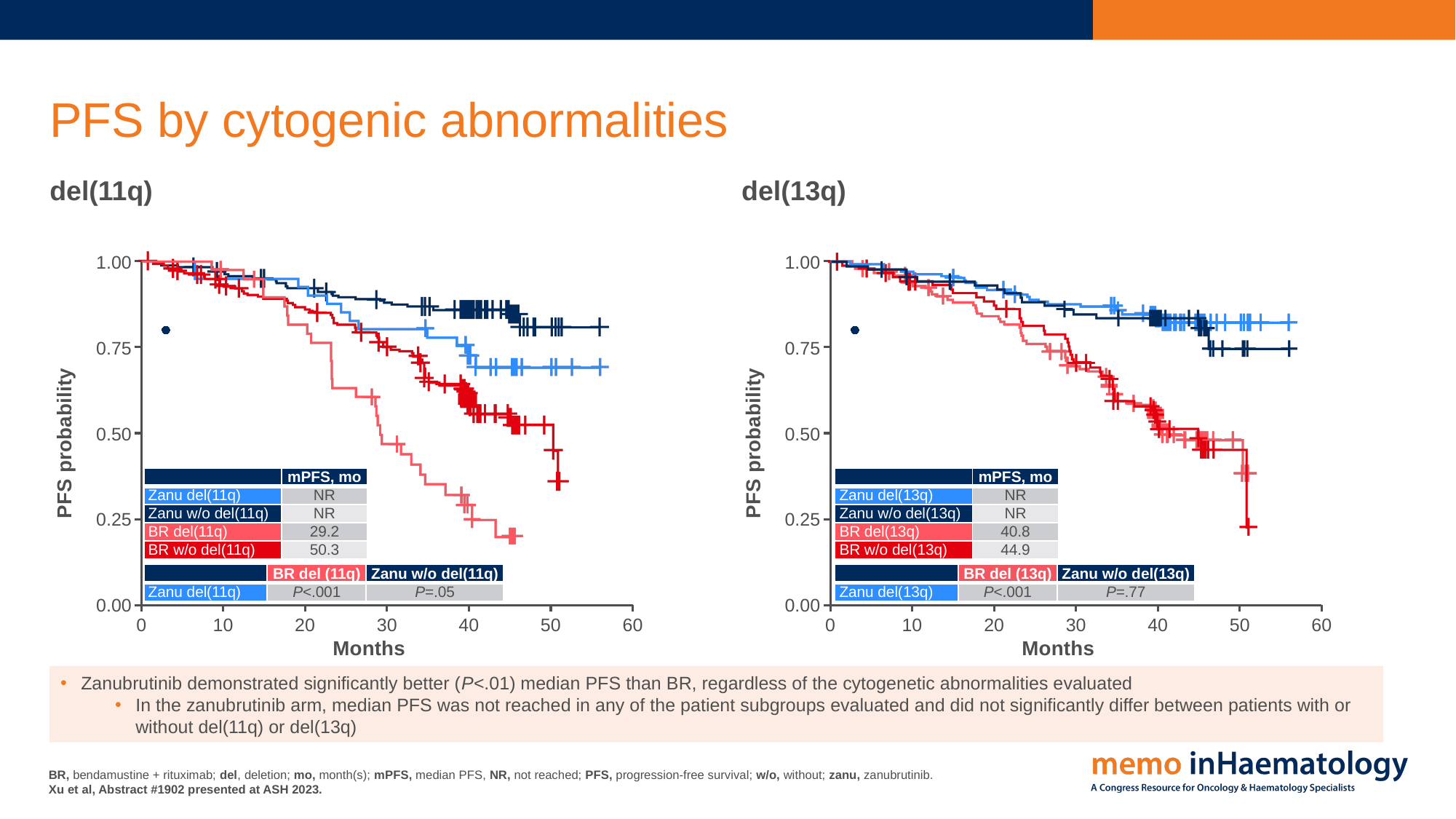
In the del(13q) chart, what is the median PFS in months for BR w/o del(13q)? 44.9 In the del(11q) chart, what is the median PFS listed for Zanu del(11q)? NR In the del(11q) chart, what is the median PFS in months for BR w/o del(11q)? 50.3 How many groups (curves) are listed in the mPFS table of the del(13q) chart? 4 In the del(13q) chart, is the PFS probability for BR w/o del(13q) at 50 months greater or less than 0.50? less In the del(11q) chart, what is the median PFS in months for BR del(11q)? 29.2 In the del(11q) chart, which has the longer median PFS: BR del(11q) or BR w/o del(11q)? BR w/o del(11q) In the del(11q) chart, what is the difference in median PFS (months) between BR w/o del(11q) and BR del(11q)? 21.1 In the del(13q) chart, what is the median PFS in months for BR del(13q)? 40.8 In the del(13q) chart, what is the P value for Zanu del(13q) versus Zanu w/o del(13q)? P=.77 In the del(13q) chart, what is the difference in median PFS (months) between BR w/o del(13q) and BR del(13q)? 4.1 In the del(11q) chart, what is the P value for Zanu del(11q) versus BR del(11q)? P<.001